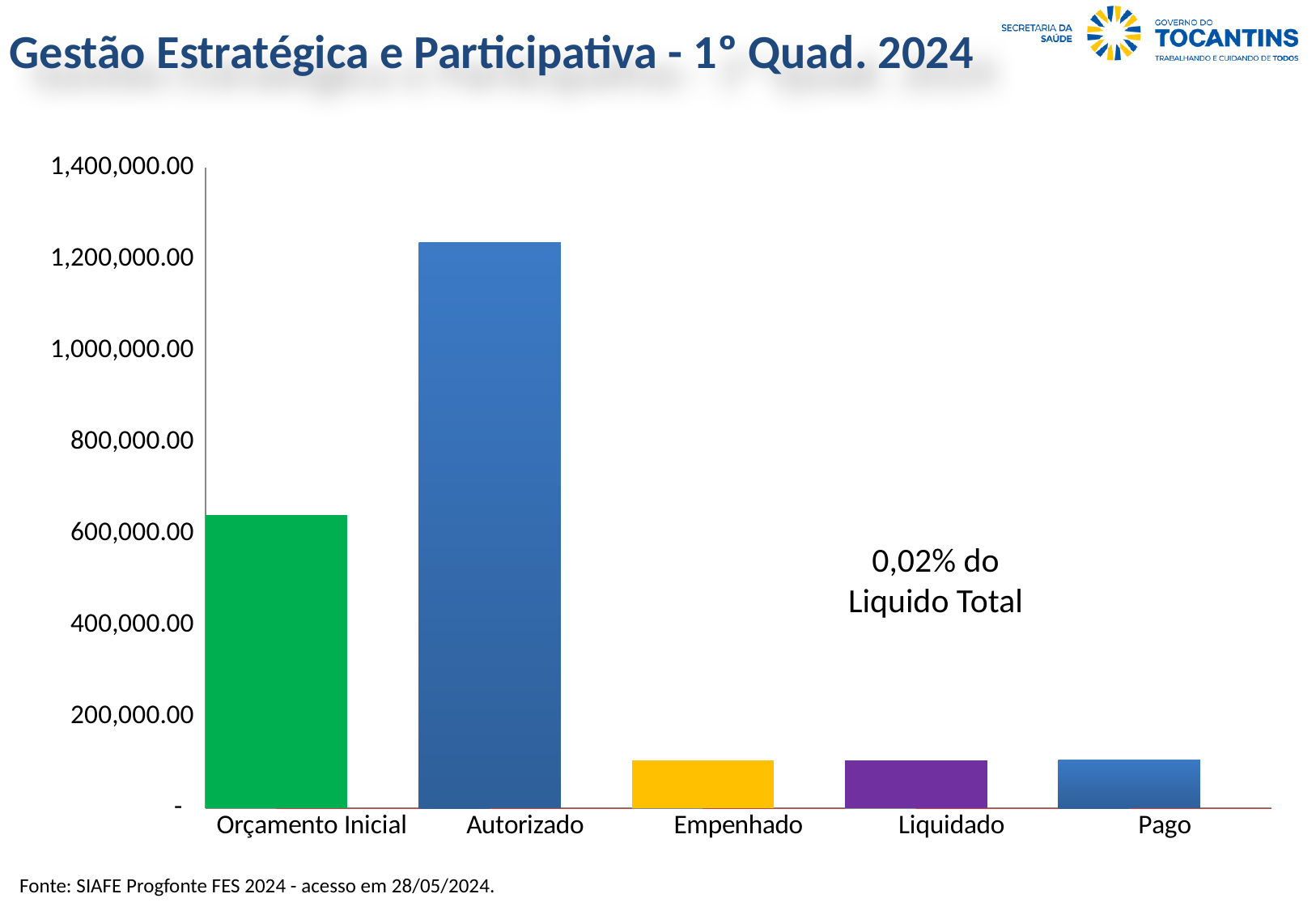
What is the title of the slide containing the chart? Gestão Estratégica e Participativa - 1° Quad. 2024 Is the value for Pago greater or less than 200,000.00? less Which is larger, the value for Orçamento Inicial or the value for Empenhado? Orçamento Inicial Is the value for Empenhado greater or less than 200,000.00? less How many categories are shown on the x axis of the chart? 5 Which category has the highest value in the chart? Autorizado What kind of chart is shown on the slide? bar chart What percentage annotation is printed next to the chart? 0,02% do Liquido Total Which is larger, the value for Orçamento Inicial or the value for Autorizado? Autorizado Is the value for Orçamento Inicial greater or less than 800,000.00? less